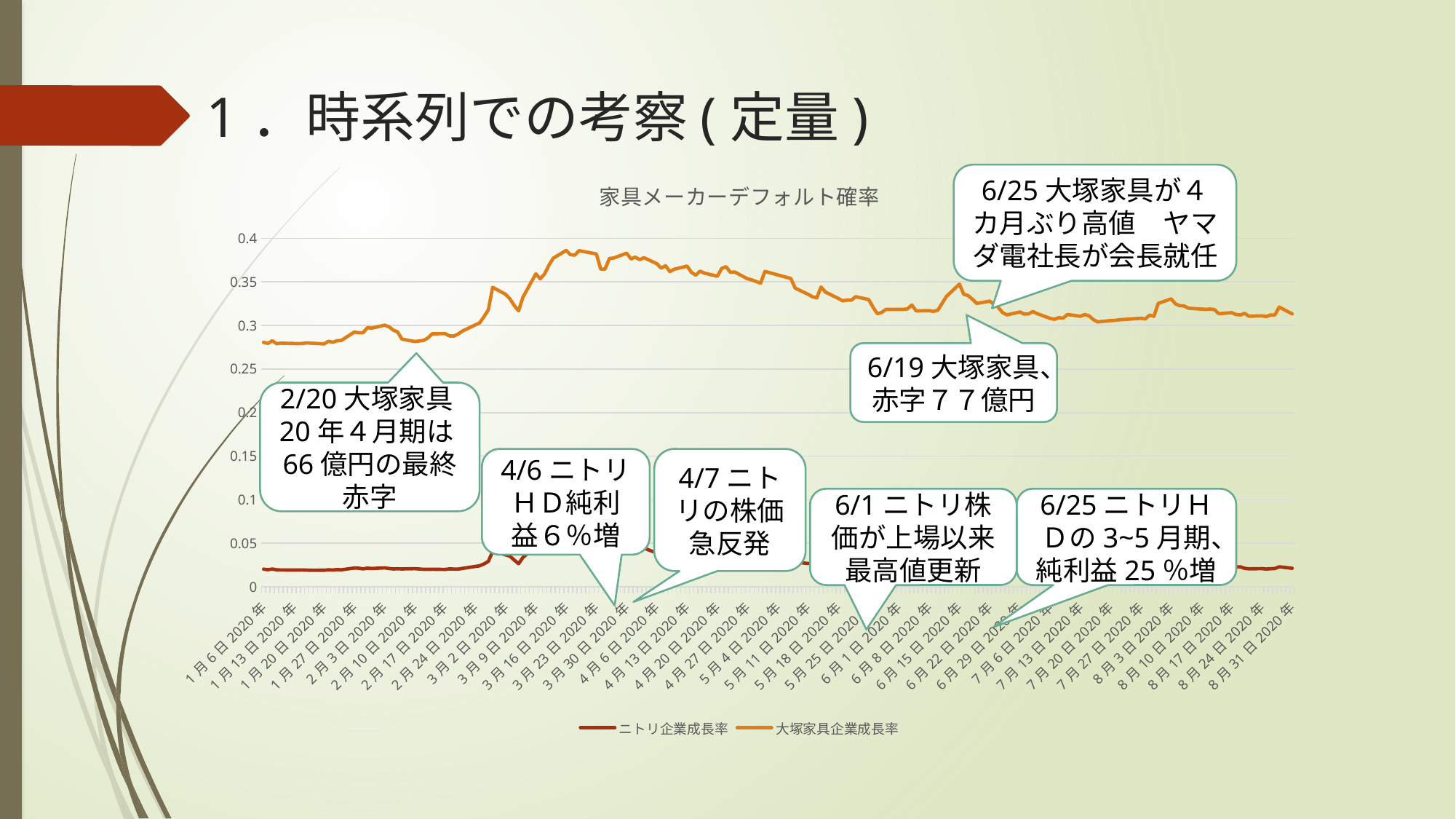
Which series is drawn in orange according to the legend? 大塚家具企業成長率 Which series reaches the lowest values on the chart? ニトリ企業成長率 What kind of chart is shown on the slide? line chart How many series does the legend list? 2 Is the value of 大塚家具企業成長率 on 1月6日2020年 greater or less than 0.3? less Which series has the higher values across the whole period, ニトリ企業成長率 or 大塚家具企業成長率? 大塚家具企業成長率 Is the value of ニトリ企業成長率 on 1月6日2020年 greater or less than 0.05? less Is the value of 大塚家具企業成長率 around 3月23日2020年 greater or less than 0.35? greater Does 大塚家具企業成長率 rise or fall between 2月17日2020年 and 3月23日2020年? rise What is the title of the chart? 家具メーカーデフォルト確率 Does 大塚家具企業成長率 rise or fall between 3月30日2020年 and 5月25日2020年? fall